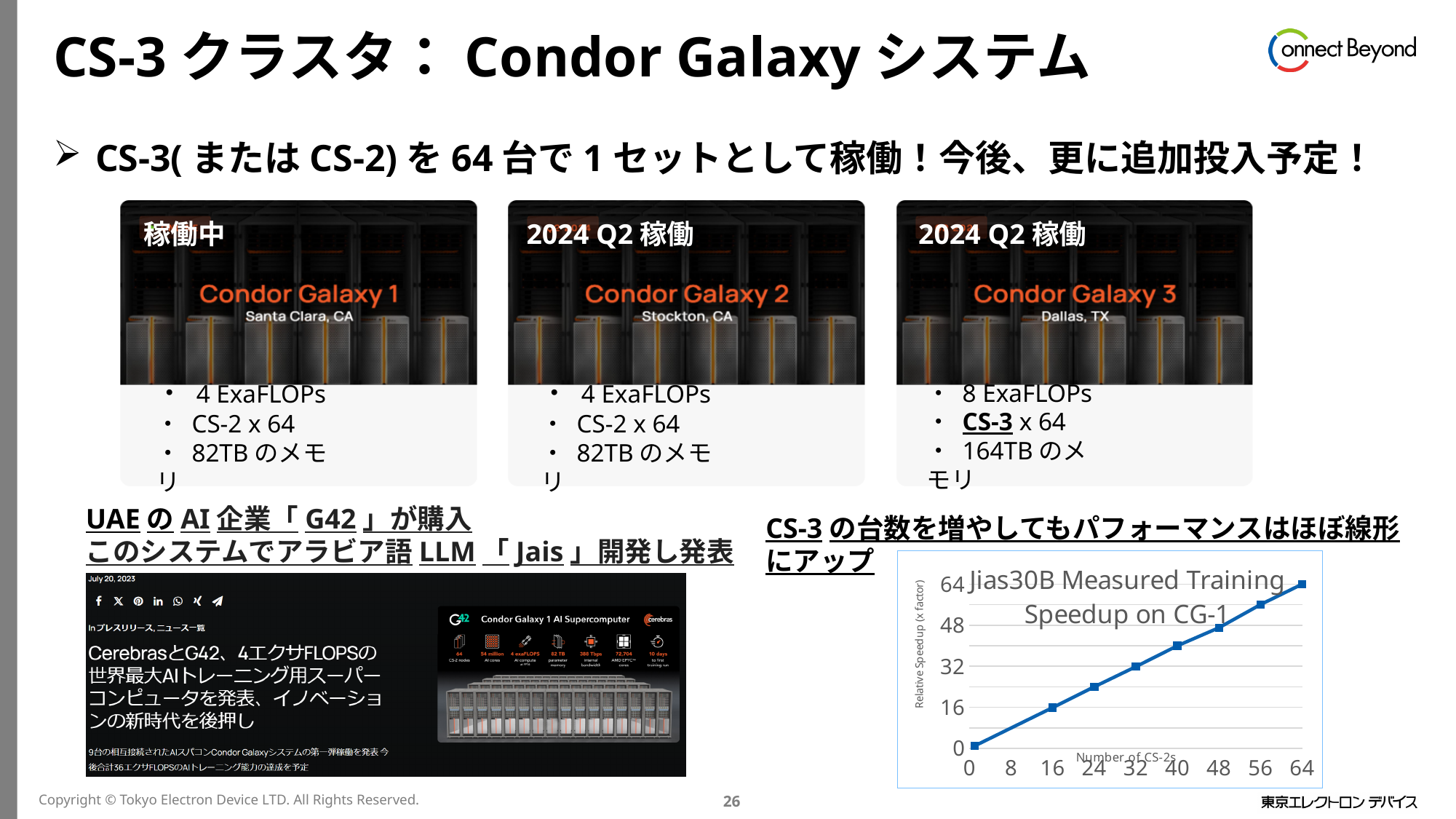
What is the x-axis label of the chart at the bottom right of the slide? Number of CS-2s In the chart at the bottom right, which has the larger relative speedup: 56 CS-2s or 24 CS-2s? 56 CS-2s In the chart at the bottom right, is the relative speedup at 40 CS-2s greater or less than 32? greater In the chart at the bottom right, does the relative speedup rise or fall as the number of CS-2s increases? Rises What is the title of the chart at the bottom right of the slide? Jias30B Measured Training Speedup on CG-1 In the chart at the bottom right, is the relative speedup at 24 CS-2s greater or less than 32? less What kind of chart is shown at the bottom right of the slide? Line chart How many data points are plotted on the line in the chart at the bottom right? 8 In the chart at the bottom right, at which number of CS-2s is the relative speedup highest? 64